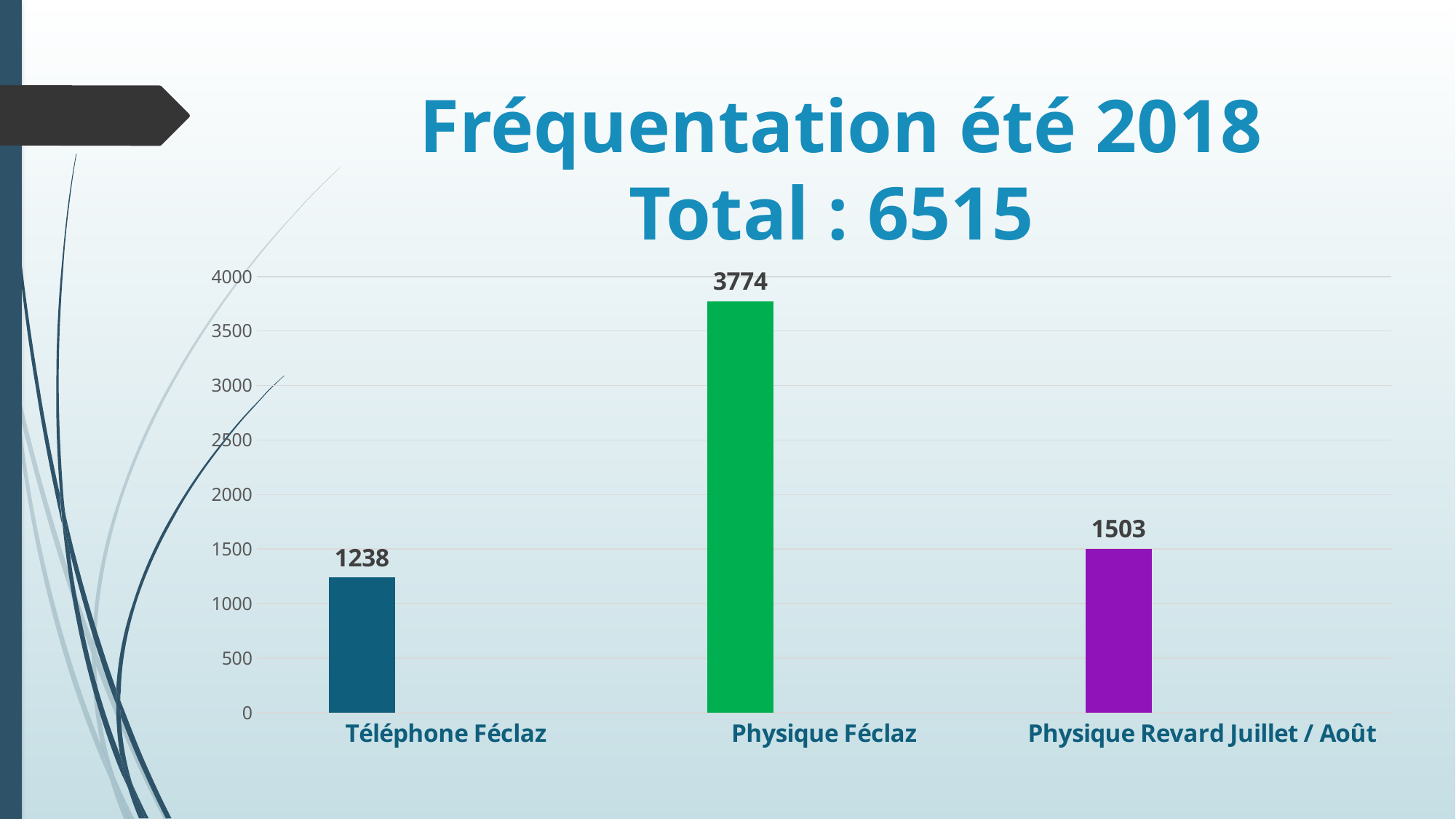
What is the value for Téléphone Féclaz? 1238 Which category has the lowest value? Téléphone Féclaz Which is larger, the value for Physique Revard Juillet / Août or the value for Téléphone Féclaz? Physique Revard Juillet / Août What total is stated in the chart title? 6515 Is the value for Physique Féclaz greater or less than 3500? greater How many categories are shown in the chart? 3 Which category has the highest value? Physique Féclaz What is the value for Physique Féclaz? 3774 What is the value for Physique Revard Juillet / Août? 1503 What is the difference between the values for Physique Féclaz and Téléphone Féclaz? 2536 What kind of chart is shown on the slide? bar chart What is the difference between the values for Physique Revard Juillet / Août and Téléphone Féclaz? 265